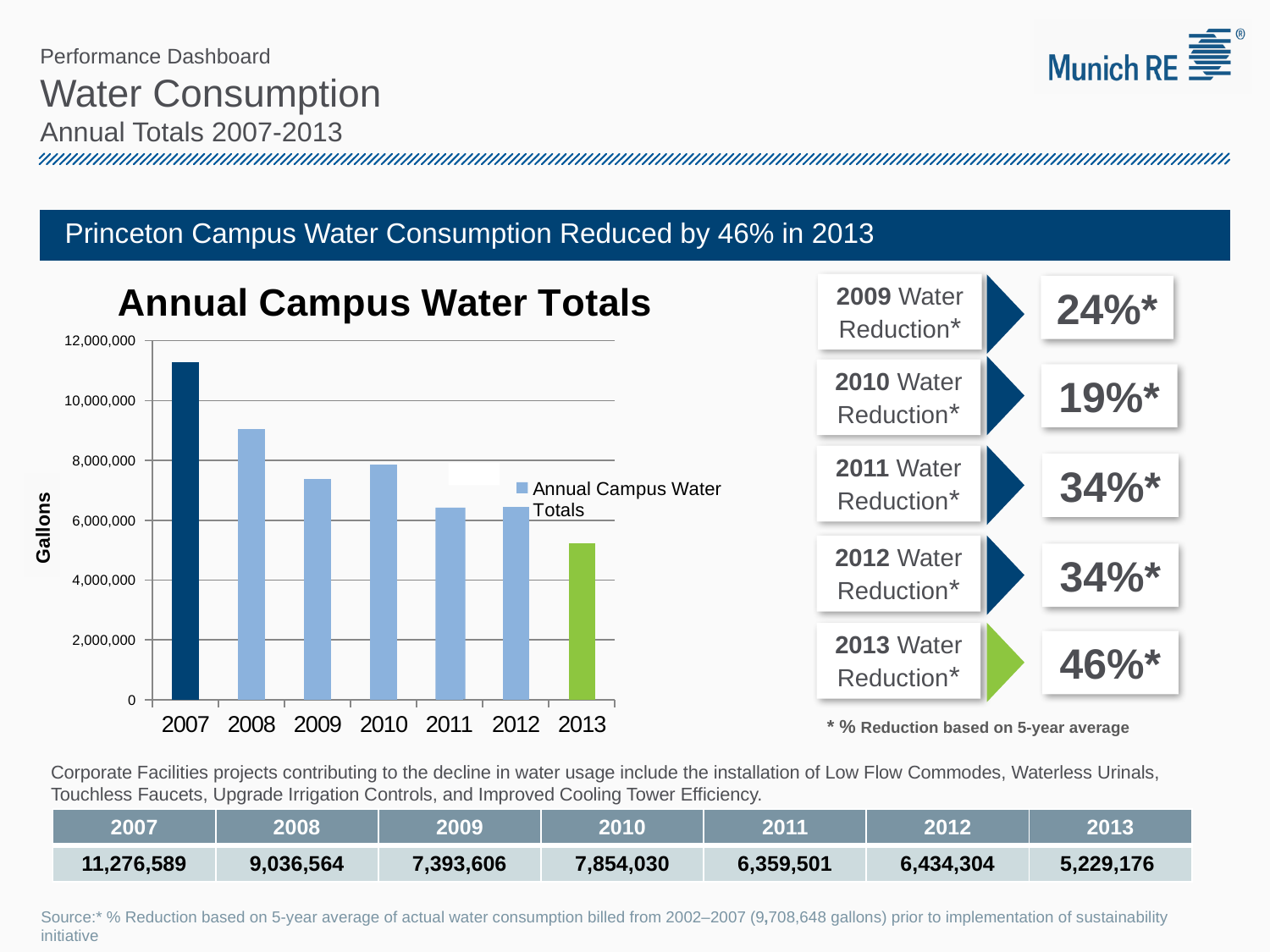
How many series does the legend of the Annual Campus Water Totals chart list? 1 Which year has the highest annual campus water total? 2007 Which year has the lowest annual campus water total? 2013 Which year has the larger annual campus water total, 2011 or 2012? 2012 What is the annual campus water total for 2013? 5,229,176 What is the difference between the annual campus water totals for 2007 and 2013? 6,047,413 How many years are plotted in the Annual Campus Water Totals chart? 7 Do the annual campus water totals generally rise or fall from 2007 to 2013? fall What is the label on the vertical axis of the Annual Campus Water Totals chart? Gallons Is the annual campus water total for 2008 greater or less than 8,000,000? greater What is the annual campus water total for 2010? 7,854,030 What kind of chart is the Annual Campus Water Totals chart? bar chart